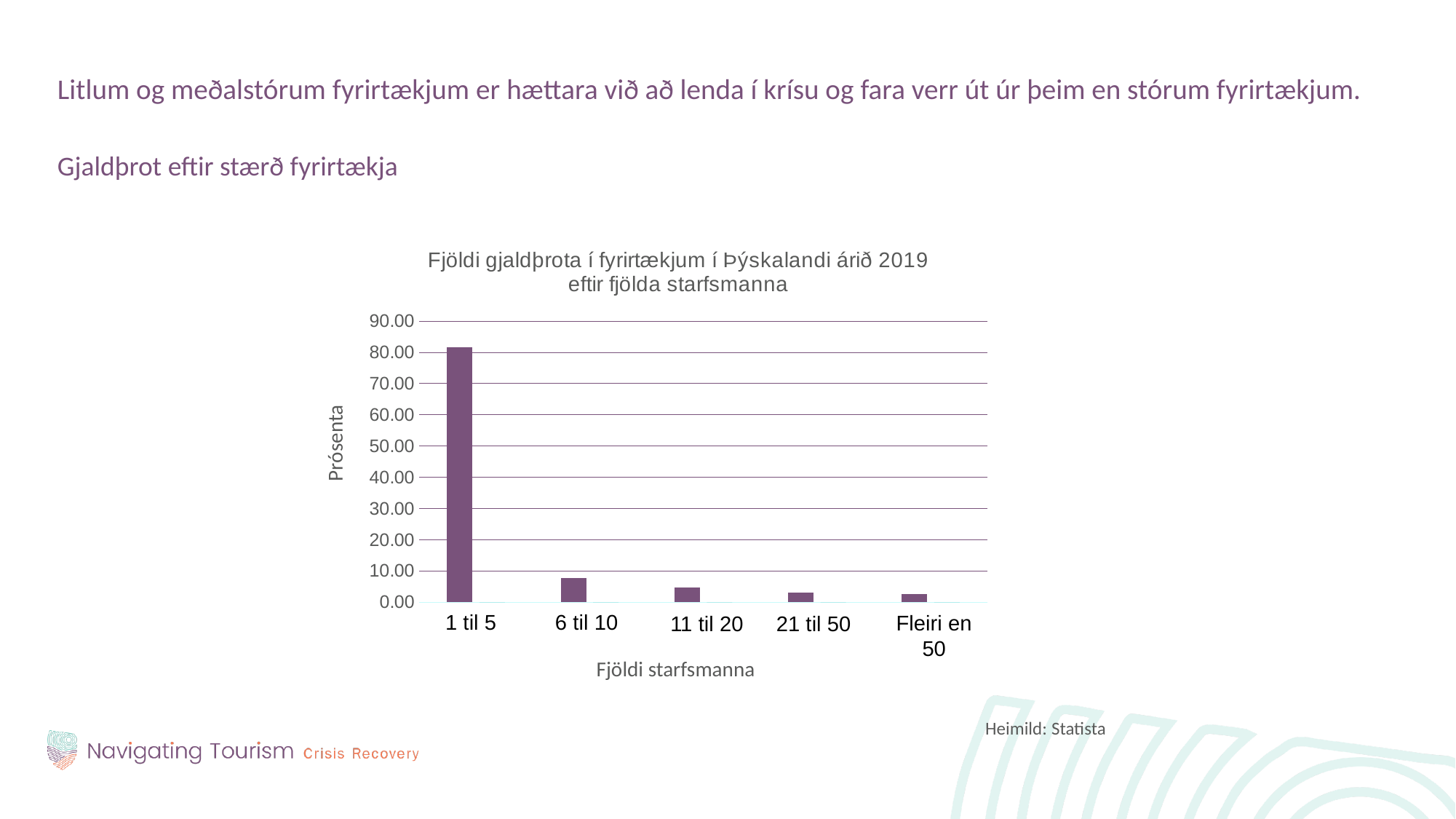
Is the value for 1 til 5 greater or less than 90.00? less Is the value for 1 til 5 greater or less than 80.00? greater Which is larger, the value for 1 til 5 or the value for Fleiri en 50? 1 til 5 Which is larger, the value for 6 til 10 or the value for 11 til 20? 6 til 10 What is the title of the chart? Fjöldi gjaldþrota í fyrirtækjum í Þýskalandi árið 2019 eftir fjölda starfsmanna Is the value for 6 til 10 greater or less than 10.00? less Which category has the highest value in the chart? 1 til 5 What type of chart is shown on the slide? bar chart What is the label of the y axis of the chart? Prósenta Do the values rise or fall moving from left to right along the x axis? fall How many categories are shown on the x axis of the chart? 5